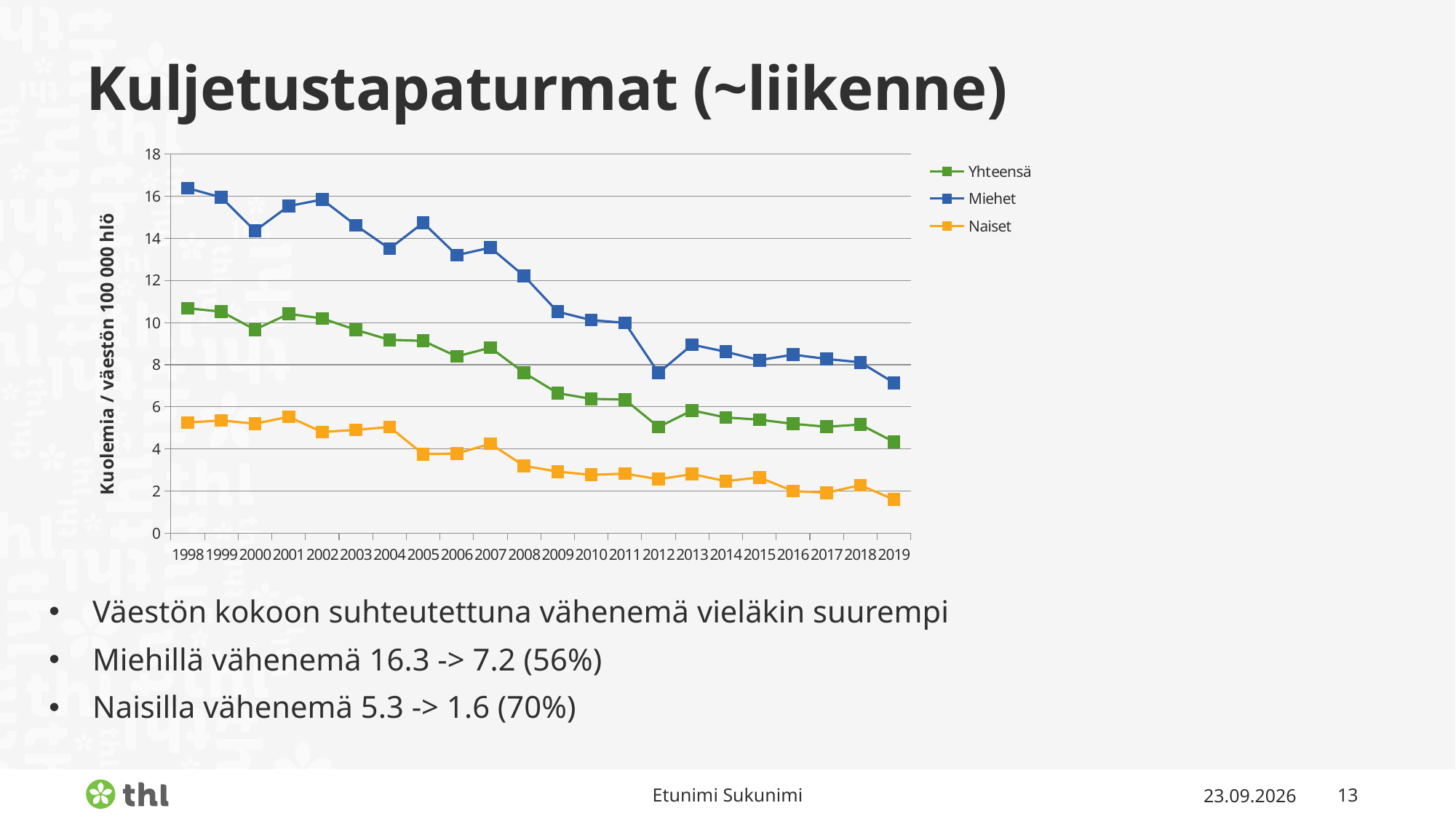
How many years are plotted along the x axis? 22 What is the value for Miehet in 1998? 16.3 Is the value for Miehet in 2012 greater or less than 8? less What is the label of the y axis? Kuolemia / väestön 100 000 hlö What is the value for Miehet in 2019? 7.2 Which series has the lowest values throughout the chart? Naiset By how much did the value for Naiset fall from 1998 to 2019? 3.7 Which series has the highest values throughout the chart? Miehet What is the value for Naiset in 2019? 1.6 What kind of chart is shown on the slide? line chart Do the values for Yhteensä rise or fall from 1998 to 2019? fall How many series does the legend list? 3